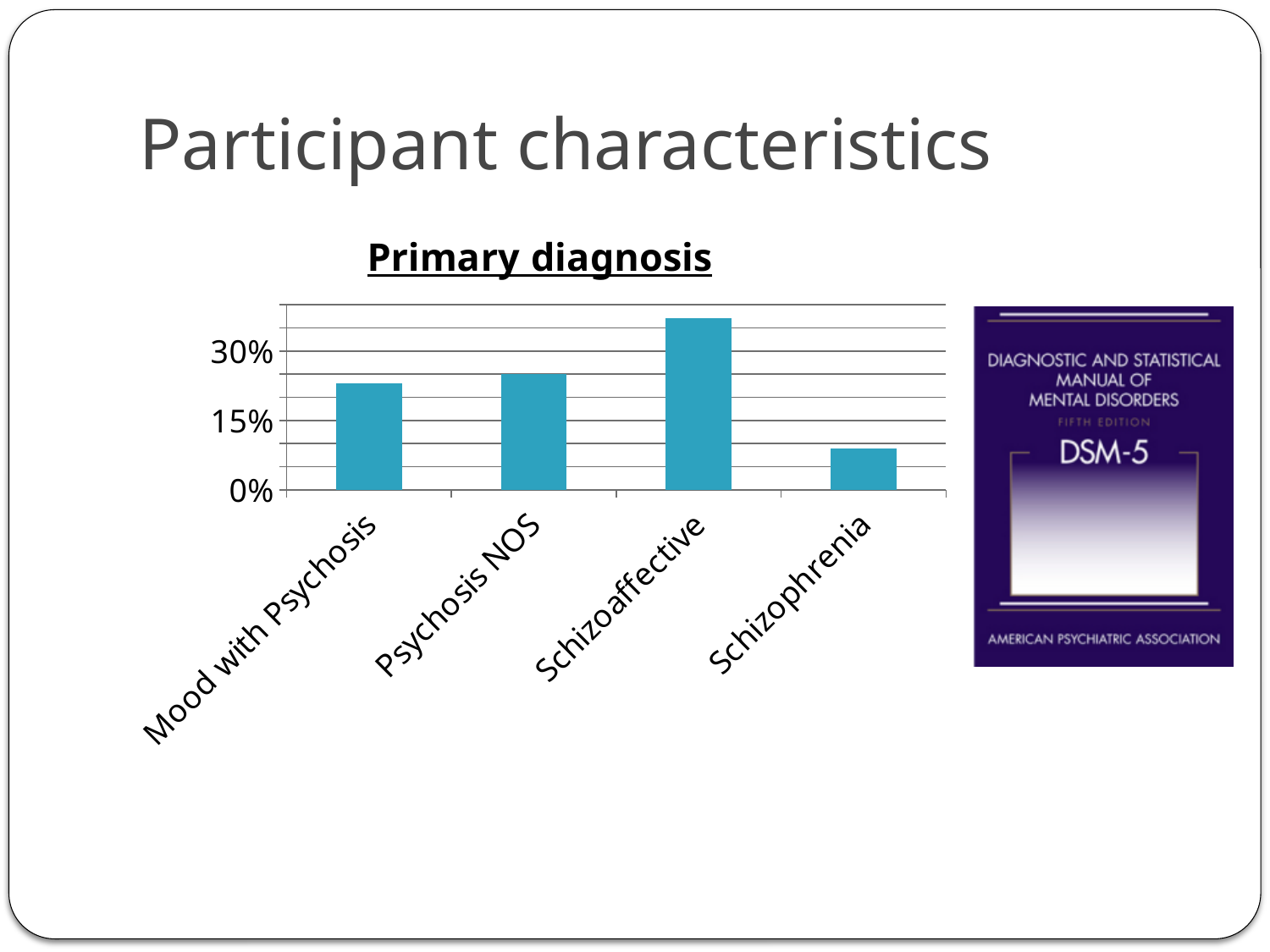
What kind of chart is shown under the title "Primary diagnosis"? bar chart How many diagnosis categories are plotted in the Primary diagnosis chart? 4 Which is larger, the value for Schizoaffective or the value for Schizophrenia? Schizoaffective Which primary diagnosis has the highest bar? Schizoaffective What is the highest percentage label shown on the vertical axis of the Primary diagnosis chart? 30% What is the title of the chart on the slide? Primary diagnosis Is the value for Schizophrenia greater or less than 15%? less Is the value for Schizoaffective greater or less than 30%? greater Which is larger, the value for Psychosis NOS or the value for Schizophrenia? Psychosis NOS Which primary diagnosis has the lowest bar? Schizophrenia Is the value for Mood with Psychosis greater or less than 15%? greater